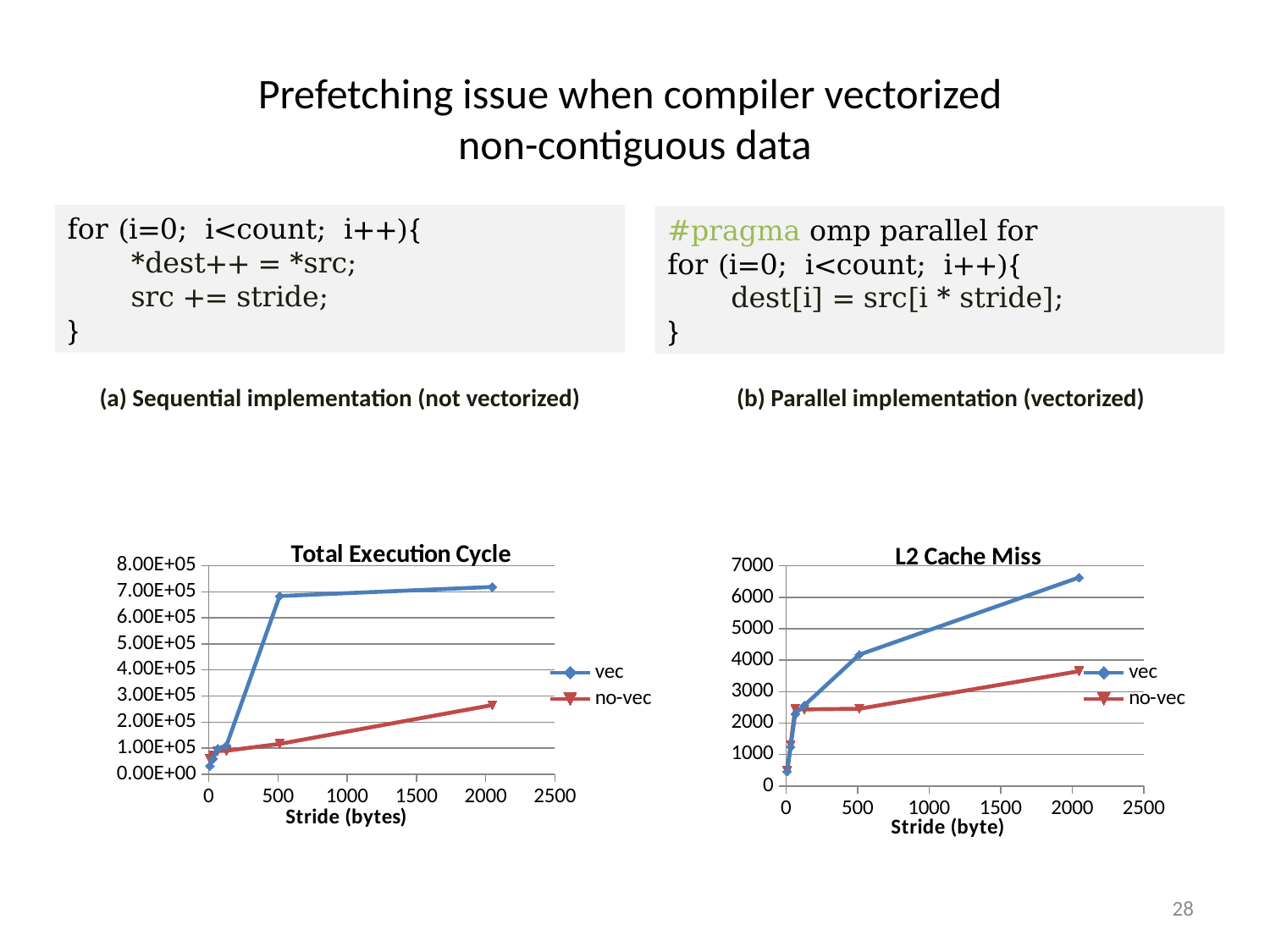
In the "L2 Cache Miss" chart, which series has the larger value at the largest stride, vec or no-vec? vec In the "Total Execution Cycle" chart, is the vec value at the largest stride (about 2000 bytes) greater or less than 6.00E+05? greater What are the two series named in the legend of the "Total Execution Cycle" chart? vec and no-vec In the "Total Execution Cycle" chart, which series has the larger value at the largest stride, vec or no-vec? vec What is the x-axis title of the "L2 Cache Miss" chart? Stride (byte) How many series does the legend of the "L2 Cache Miss" chart list? 2 In the "Total Execution Cycle" chart, is the no-vec value at the largest stride (about 2000 bytes) greater or less than 3.00E+05? less In the "L2 Cache Miss" chart, does the vec series rise or fall as stride increases? rise In the "Total Execution Cycle" chart, is the vec value at stride 500 greater or less than 5.00E+05? greater What type of chart is the "Total Execution Cycle" chart? line chart